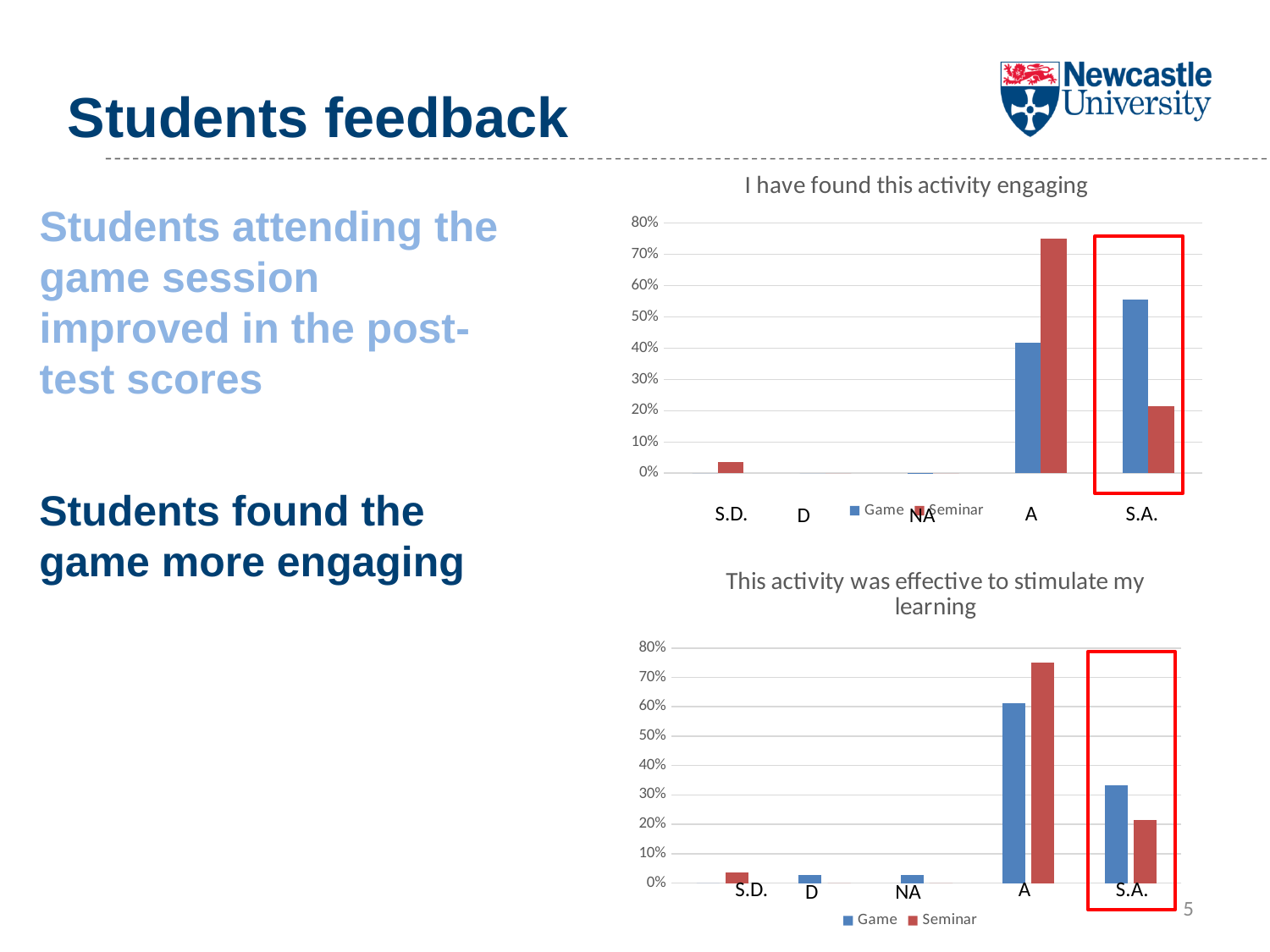
What kind of chart is the chart titled "I have found this activity engaging"? bar chart In the chart titled "This activity was effective to stimulate my learning", is the Seminar value for S.A. greater or less than 30%? less In the chart titled "This activity was effective to stimulate my learning", which colour represents the Seminar series? red In the chart titled "I have found this activity engaging", which category has the highest value for the Seminar series? A In the chart titled "This activity was effective to stimulate my learning", which category has the highest value for the Game series? A In the chart titled "I have found this activity engaging", which is larger for S.A., Game or Seminar? Game In the chart titled "I have found this activity engaging", is the Game value for S.A. greater or less than 50%? greater In the chart titled "I have found this activity engaging", is the Seminar value for A greater or less than 70%? greater How many series does the legend list in the chart titled "I have found this activity engaging"? 2 How many categories are shown on the x axis of the chart titled "This activity was effective to stimulate my learning"? 5 In the chart titled "This activity was effective to stimulate my learning", which is larger for S.A., Game or Seminar? Game In the chart titled "I have found this activity engaging", which is larger for A, Game or Seminar? Seminar